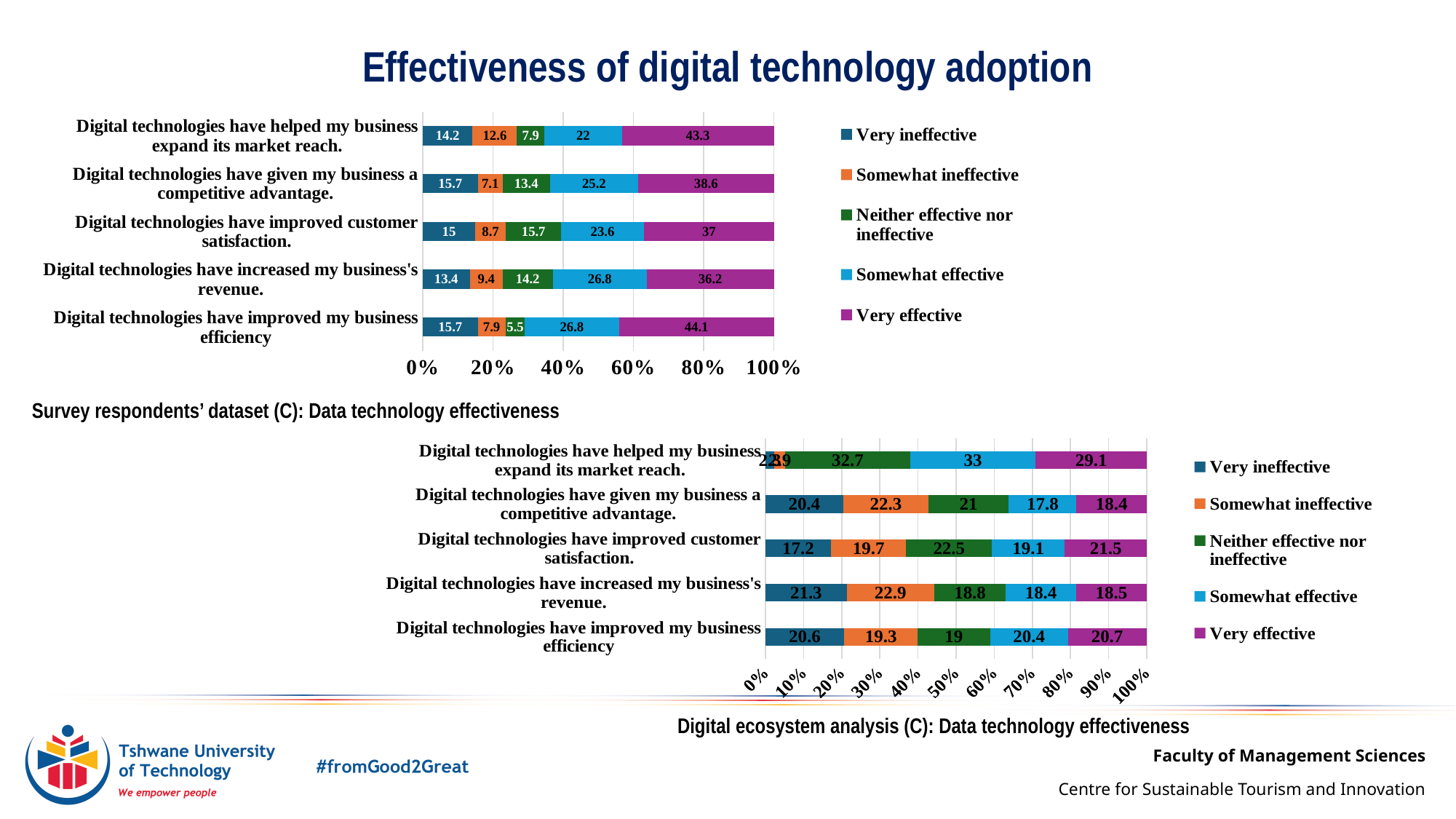
In the bottom chart (Digital ecosystem analysis), what is the 'Somewhat ineffective' value for 'Digital technologies have increased my business's revenue'? 22.9 In the top chart (Survey respondents' dataset), which statement has the highest 'Very effective' value? Digital technologies have improved my business efficiency How many series does the legend of the top chart (Survey respondents' dataset) list? 5 In the top chart (Survey respondents' dataset), which is larger: the 'Somewhat ineffective' value for 'expand its market reach' or for 'given my business a competitive advantage'? expand its market reach In the top chart (Survey respondents' dataset), what is the difference between the 'Very effective' values for 'expand its market reach' and 'improved customer satisfaction'? 6.3 In the top chart (Survey respondents' dataset), what is the 'Somewhat effective' value for 'Digital technologies have increased my business's revenue'? 26.8 In the top chart (Survey respondents' dataset), which statement has the lowest 'Neither effective nor ineffective' value? Digital technologies have improved my business efficiency In the bottom chart (Digital ecosystem analysis), what is the 'Neither effective nor ineffective' value for 'Digital technologies have improved customer satisfaction'? 22.5 What type of chart is the bottom chart (Digital ecosystem analysis)? Stacked bar chart In the bottom chart (Digital ecosystem analysis), what is the difference between the 'Very ineffective' values for 'increased my business's revenue' and 'improved customer satisfaction'? 4.1 In the bottom chart (Digital ecosystem analysis), which statement has the highest 'Very effective' value? Digital technologies have helped my business expand its market reach In the top chart (Survey respondents' dataset), what is the 'Very effective' value for 'Digital technologies have improved my business efficiency'? 44.1